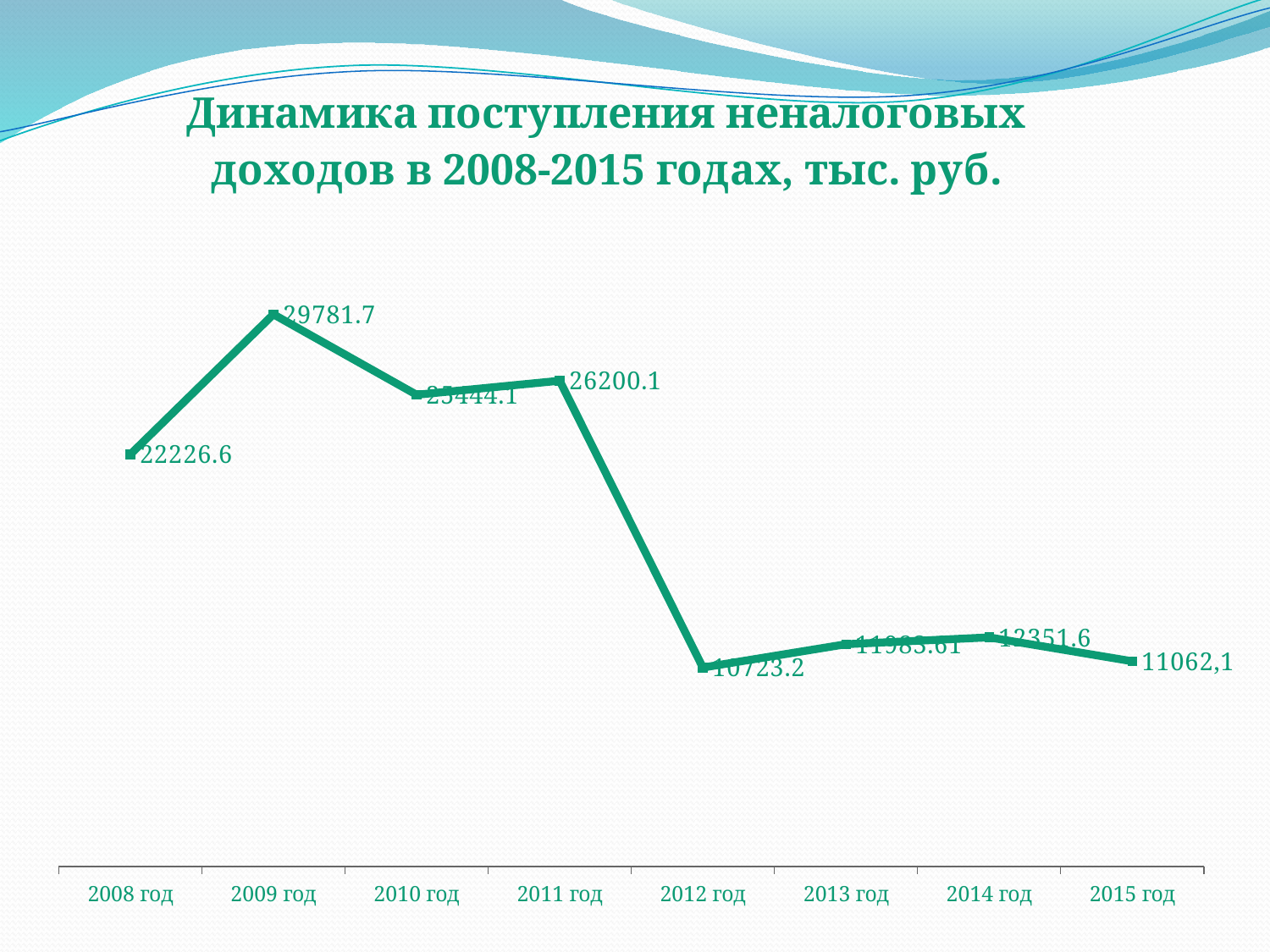
What is the difference between the values for 2009 год and 2008 год? 7555.1 Which is larger, the value for 2011 год or the value for 2014 год? 2011 год Which year has the lowest value? 2012 год What is the value for 2015 год? 11062,1 What is the value for 2009 год? 29781.7 Does the value rise or fall from 2011 год to 2012 год? Fall What is the value for 2014 год? 12351.6 Which year has the highest value? 2009 год What is the value for 2008 год? 22226.6 How many years are plotted on the x axis? 8 What is the value for 2011 год? 26200.1 What type of chart is shown on the slide? Line chart